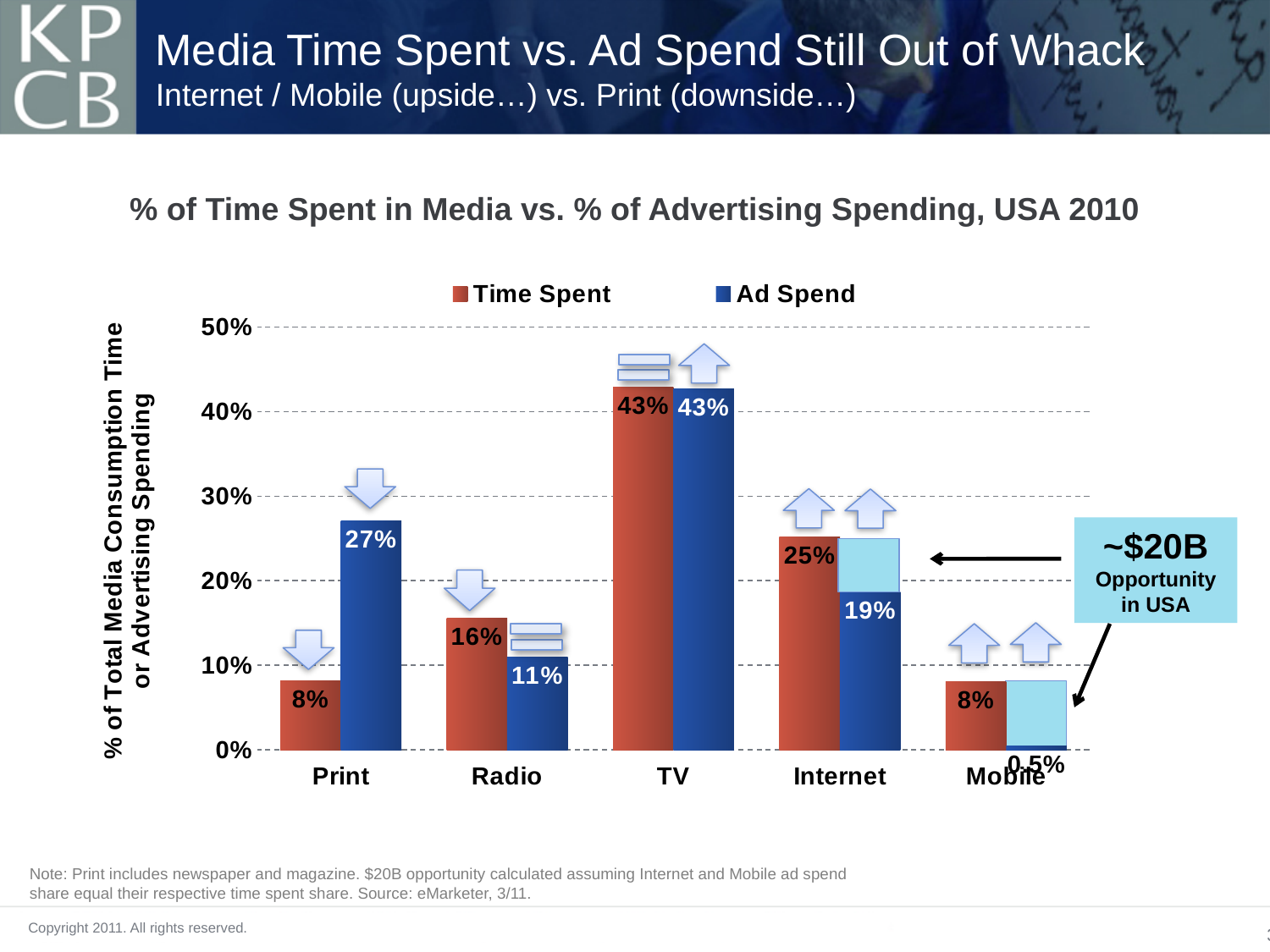
What is the Ad Spend value for Print? 27% Which category has the lowest Ad Spend value? Mobile What kind of chart is shown on the slide? Bar chart What is the Ad Spend value for Mobile? 0.5% What is the Time Spent value for Print? 8% What is the difference between Ad Spend and Time Spent for Print? 19% What is the difference between Time Spent and Ad Spend for Internet? 6% For Radio, which is larger: Time Spent or Ad Spend? Time Spent Which category has the highest Time Spent value? TV What is the Ad Spend value for Internet? 19% How many media categories are shown on the x axis? 5 How many series does the legend list? 2